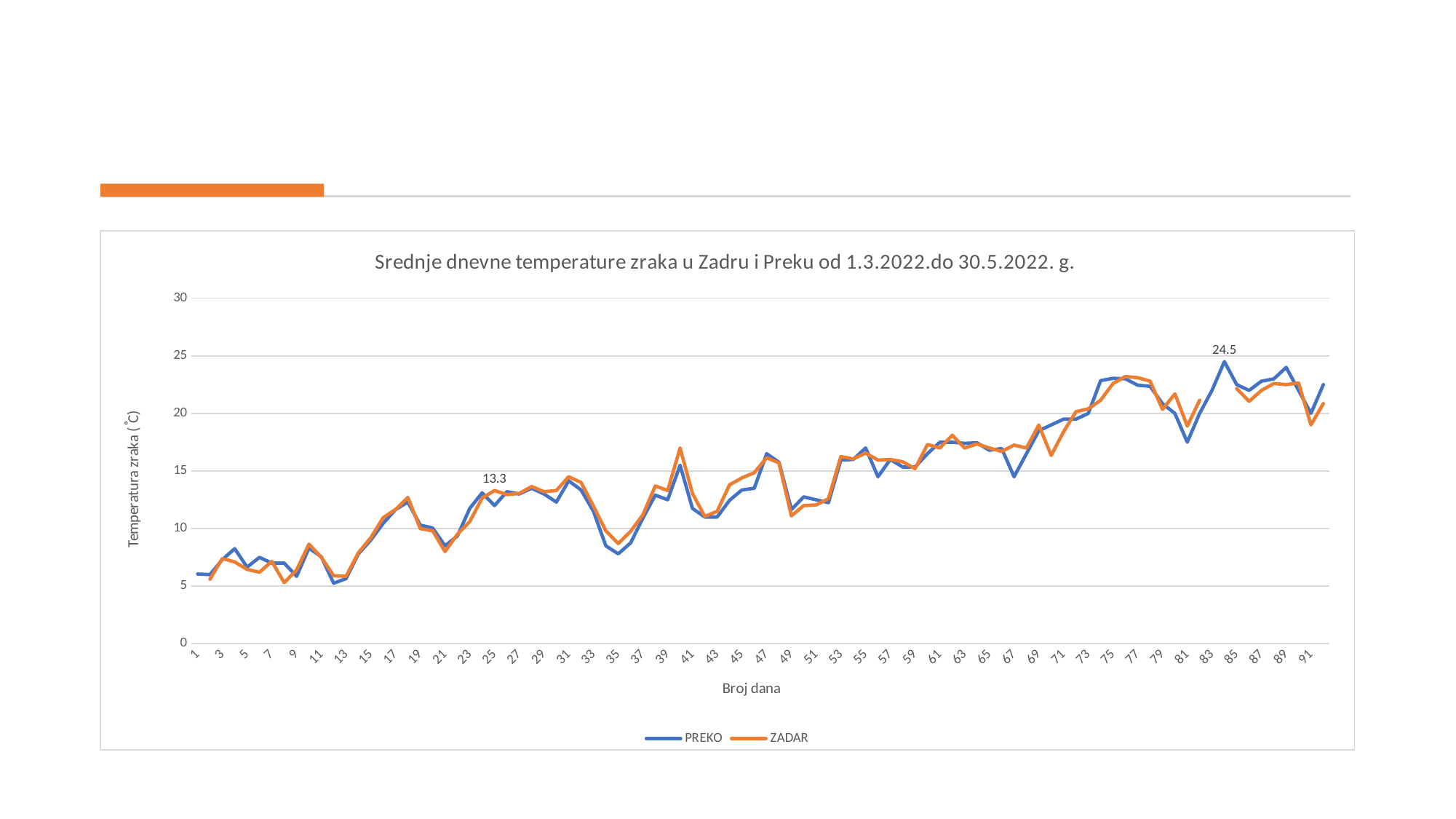
At day 67, which series has the higher value, PREKO or ZADAR? ZADAR What is the title of the x axis? Broj dana Which series reaches the highest temperature on the chart? PREKO Is the PREKO value at day 75 greater or less than 20? greater What are the two series named in the legend? PREKO and ZADAR Overall, do the temperatures rise or fall from day 1 to day 91? rise How many series does the legend list? 2 Is the PREKO value at day 1 greater or less than 10? less What is the highest labelled value on the PREKO line? 24.5 What kind of chart is shown on the slide? line chart